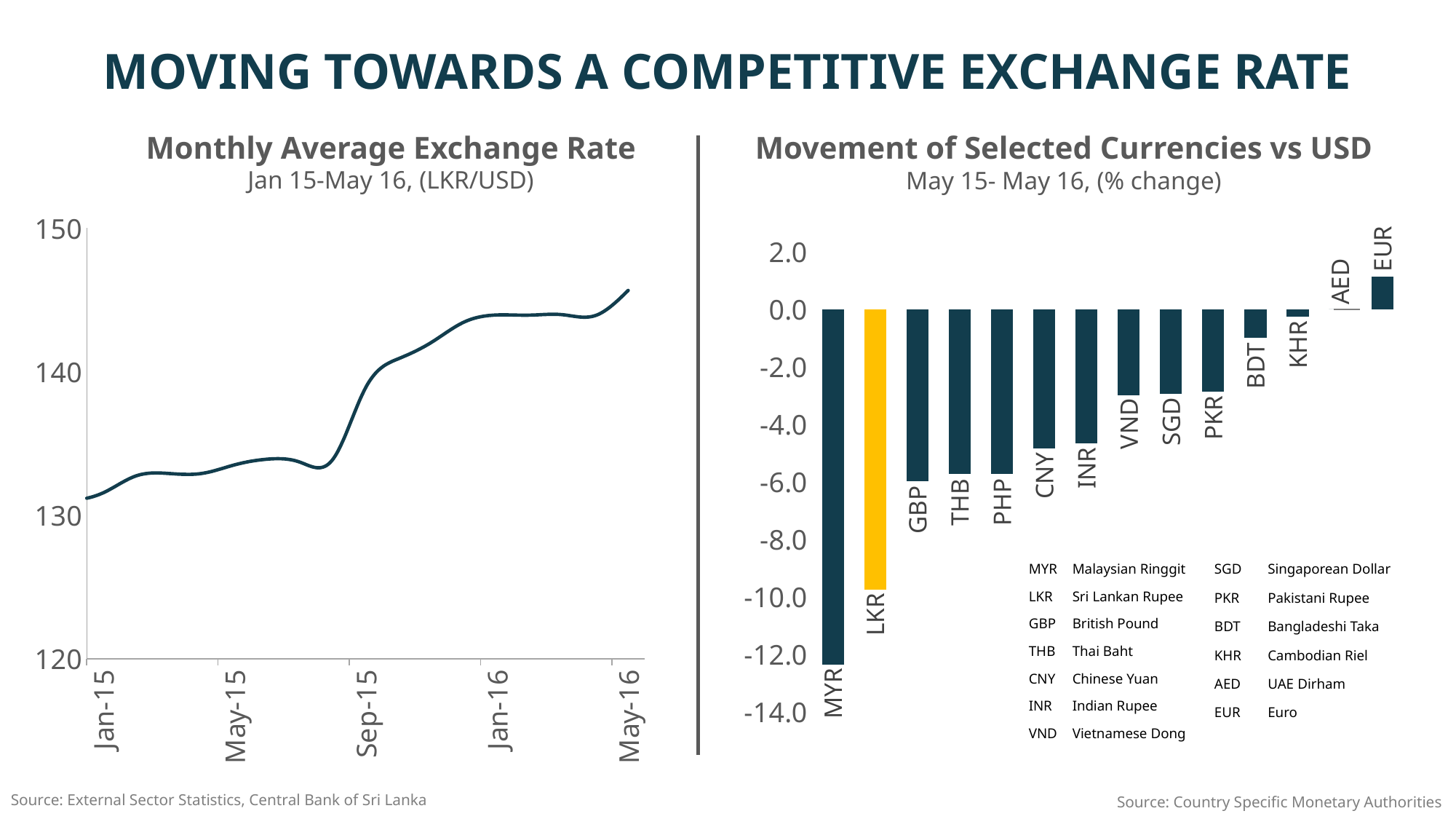
In the Movement of Selected Currencies vs USD chart, which currency has the lowest value? MYR In the Movement of Selected Currencies vs USD chart, is the value for LKR greater or less than -8.0? less In the Monthly Average Exchange Rate chart, does the exchange rate rise or fall overall from Jan-15 to May-16? rise In the Monthly Average Exchange Rate chart, is the value at Jan-15 greater or less than 140? less What kind of chart is the Monthly Average Exchange Rate chart on the left? line chart In the Movement of Selected Currencies vs USD chart, which is larger, the value for MYR or the value for LKR? LKR In the Movement of Selected Currencies vs USD chart, how many currencies are shown? 14 What kind of chart is the Movement of Selected Currencies vs USD chart on the right? bar chart In the Movement of Selected Currencies vs USD chart, is the value for BDT greater or less than -2.0? greater In the Movement of Selected Currencies vs USD chart, which bar is coloured yellow instead of dark blue? LKR In the Movement of Selected Currencies vs USD chart, which currency has the highest value? EUR